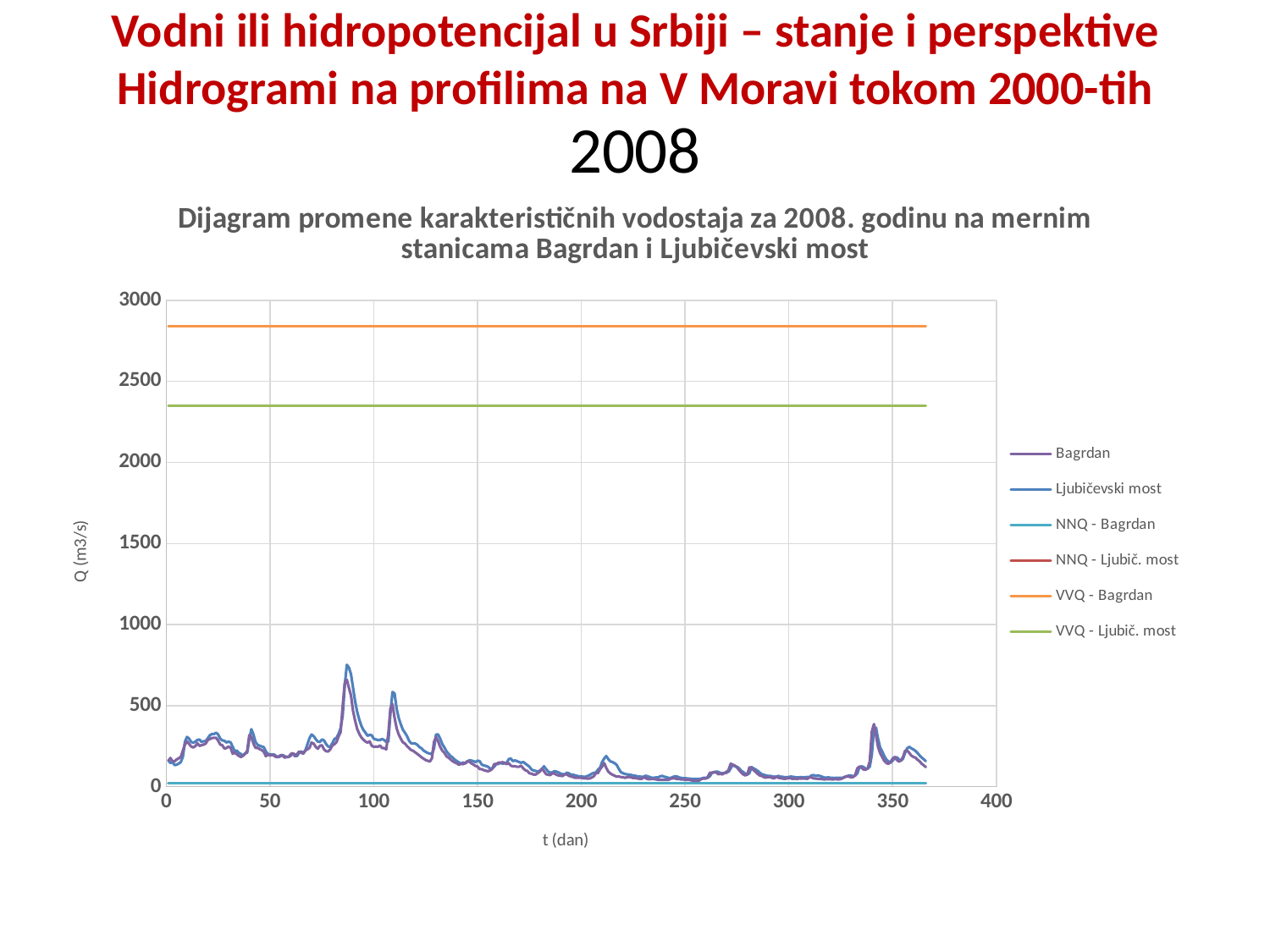
What is the label of the vertical axis? Q (m3/s) Is the value of the NNQ - Bagrdan line greater or less than 500? less How many series does the legend list? 6 Is the value of the VVQ - Bagrdan line greater or less than 2500? greater Which is larger, the VVQ - Bagrdan line or the VVQ - Ljubič. most line? VVQ - Bagrdan Which series has the highest values on the chart? VVQ - Bagrdan What kind of chart is shown on the slide? line chart What is the title of the chart? Dijagram promene karakterističnih vodostaja za 2008. godinu na mernim stanicama Bagrdan i Ljubičevski most Is the highest peak of the Ljubičevski most series greater or less than 1000? less Does the VVQ - Bagrdan line rise, fall, or stay constant along the x axis? stays constant